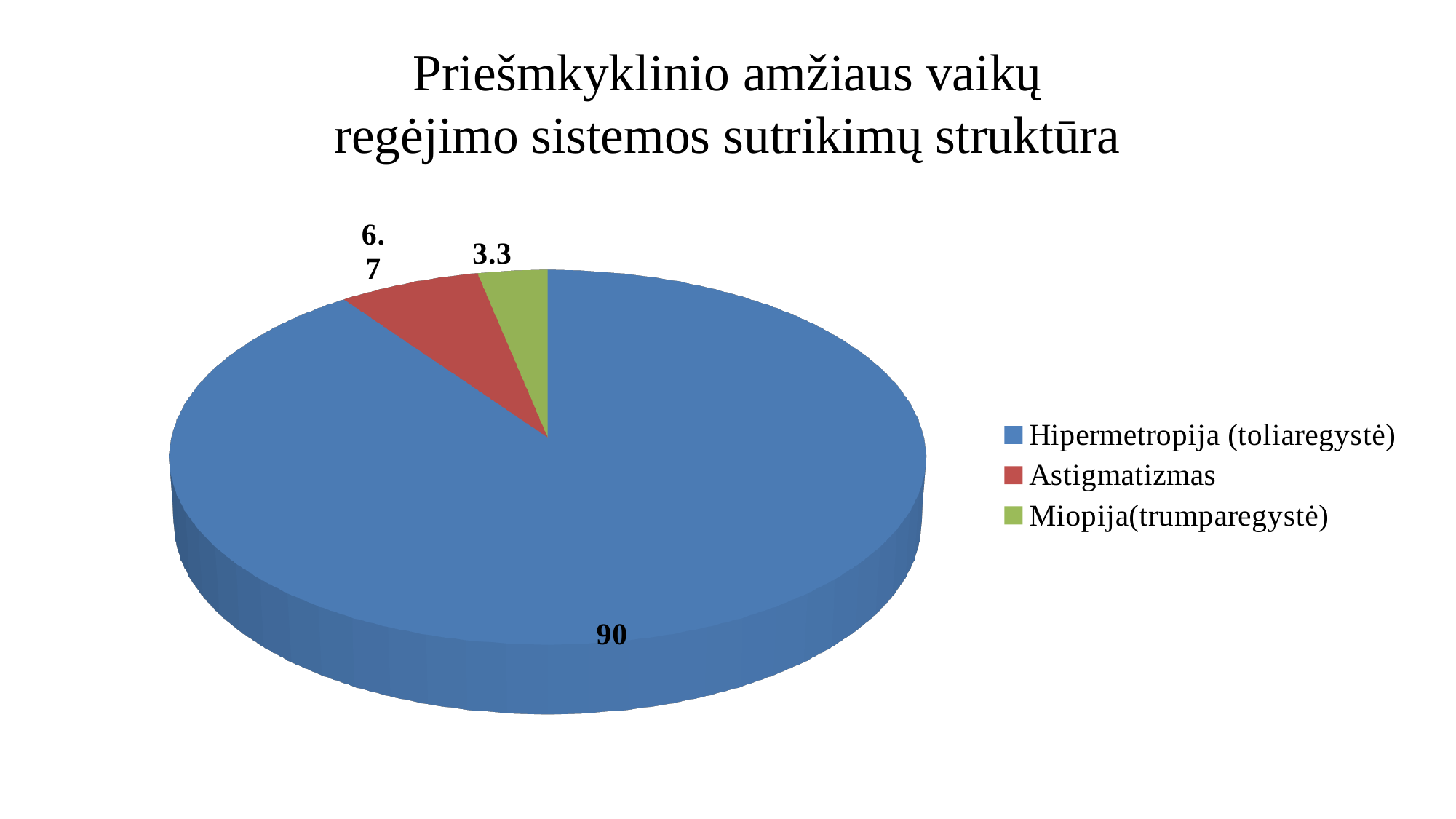
What is the difference between the values for Hipermetropija (toliaregystė) and Astigmatizmas? 83.3 How many entries does the legend list? 3 What is the value for Miopija(trumparegystė)? 3.3 What colour is the slice for Astigmatizmas? red Which category has the largest slice of the pie? Hipermetropija (toliaregystė) What type of chart is shown on the slide? pie chart What is the value for Hipermetropija (toliaregystė)? 90 What is the value for Astigmatizmas? 6.7 How many slices does the pie chart have? 3 Which category has the smallest slice of the pie? Miopija(trumparegystė) Which is larger, the value for Astigmatizmas or the value for Miopija(trumparegystė)? Astigmatizmas What is the difference between the values for Astigmatizmas and Miopija(trumparegystė)? 3.4